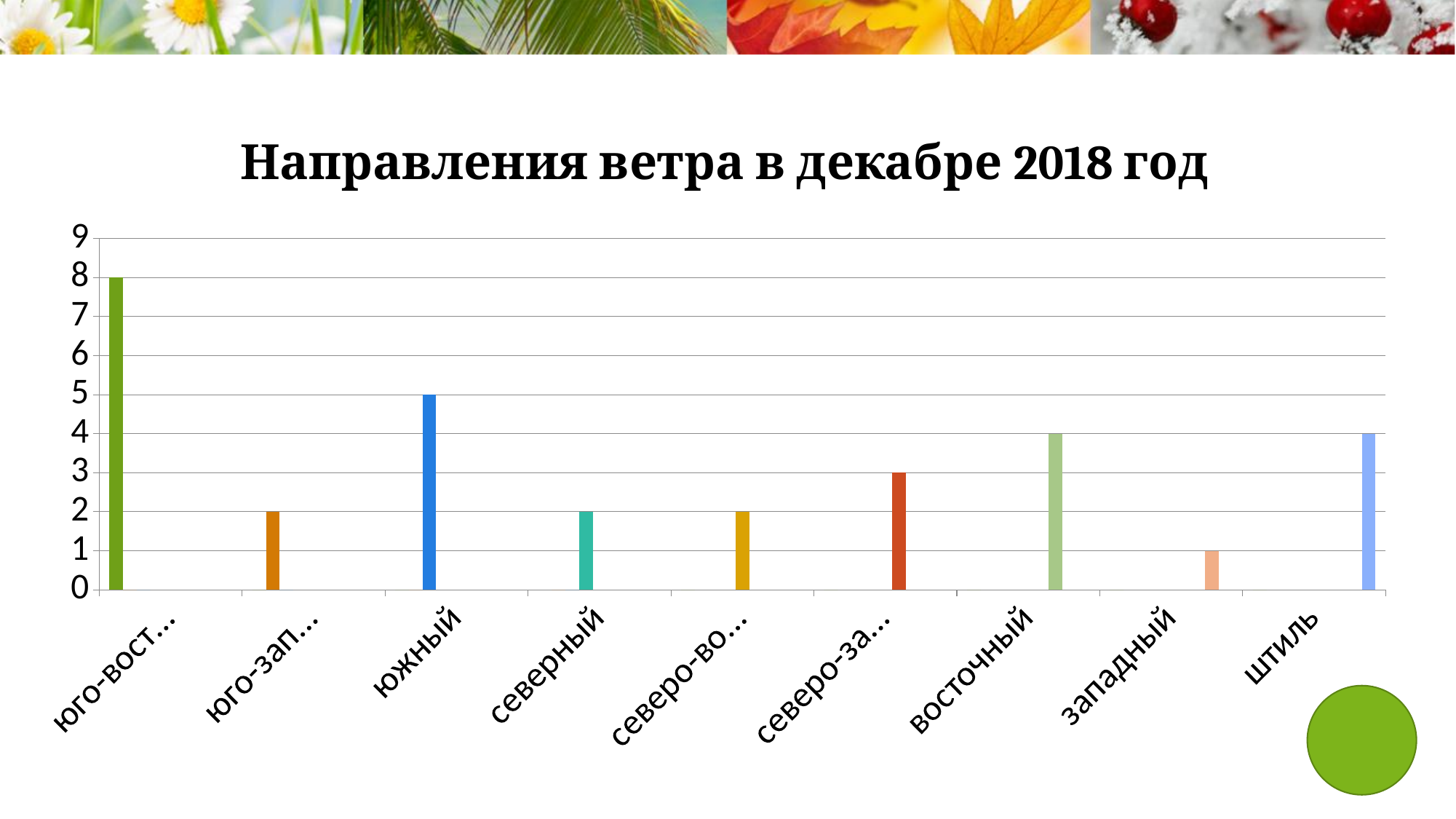
What is the highest value reached by any bar in the chart? 8 How many categories are shown on the x axis? 9 Which is larger, the value for восточный or the value for западный? восточный What is the title of the chart? Направления ветра в декабре 2018 год What kind of chart is shown on the slide? bar chart What is the value for западный? 1 What is the value for северный? 2 What is the difference between the values for южный and северный? 3 What is the value for южный? 5 What is the value for восточный? 4 Which category has the lowest value? западный What is the value for штиль? 4